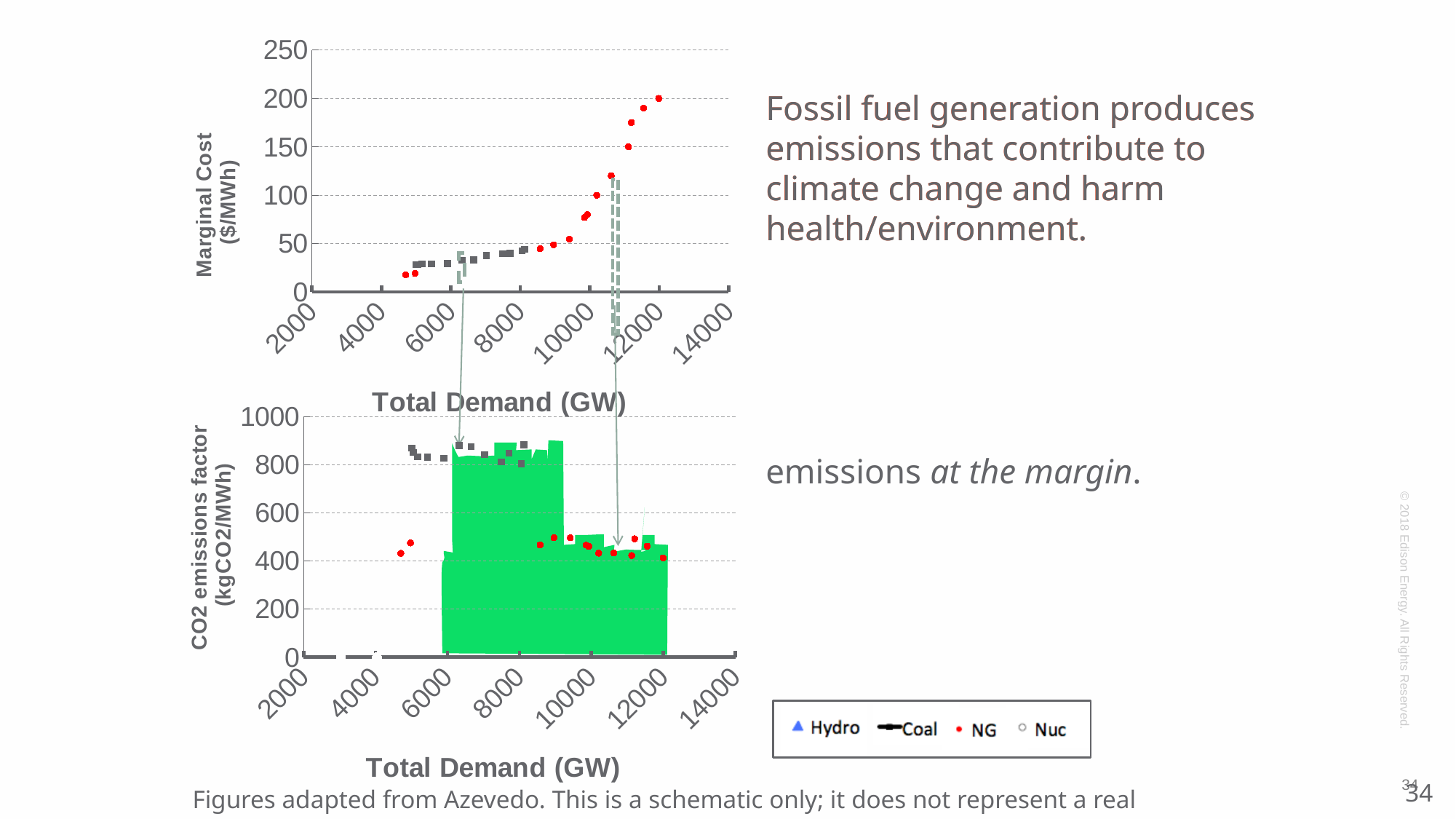
In the top chart, are the Coal points near 6000 GW greater or less than 50 $/MWh? less In the top chart, is the marginal cost of the highest NG point (near 12000 GW) greater or less than 150? greater How many series does the legend list? 4 In the bottom chart, are the Coal points between 6000 and 8000 GW greater or less than 600 kgCO2/MWh? greater In the top chart, do marginal cost values rise or fall as total demand increases along the x axis? rise What kind of chart is the top chart (Marginal Cost vs Total Demand)? scatter chart In the top chart, which series reaches the highest marginal cost? NG In the bottom chart, which series has the higher CO2 emissions factor, Coal or NG? Coal What is the x-axis label of the bottom chart? Total Demand (GW) What is the y-axis label of the top chart? Marginal Cost ($/MWh)